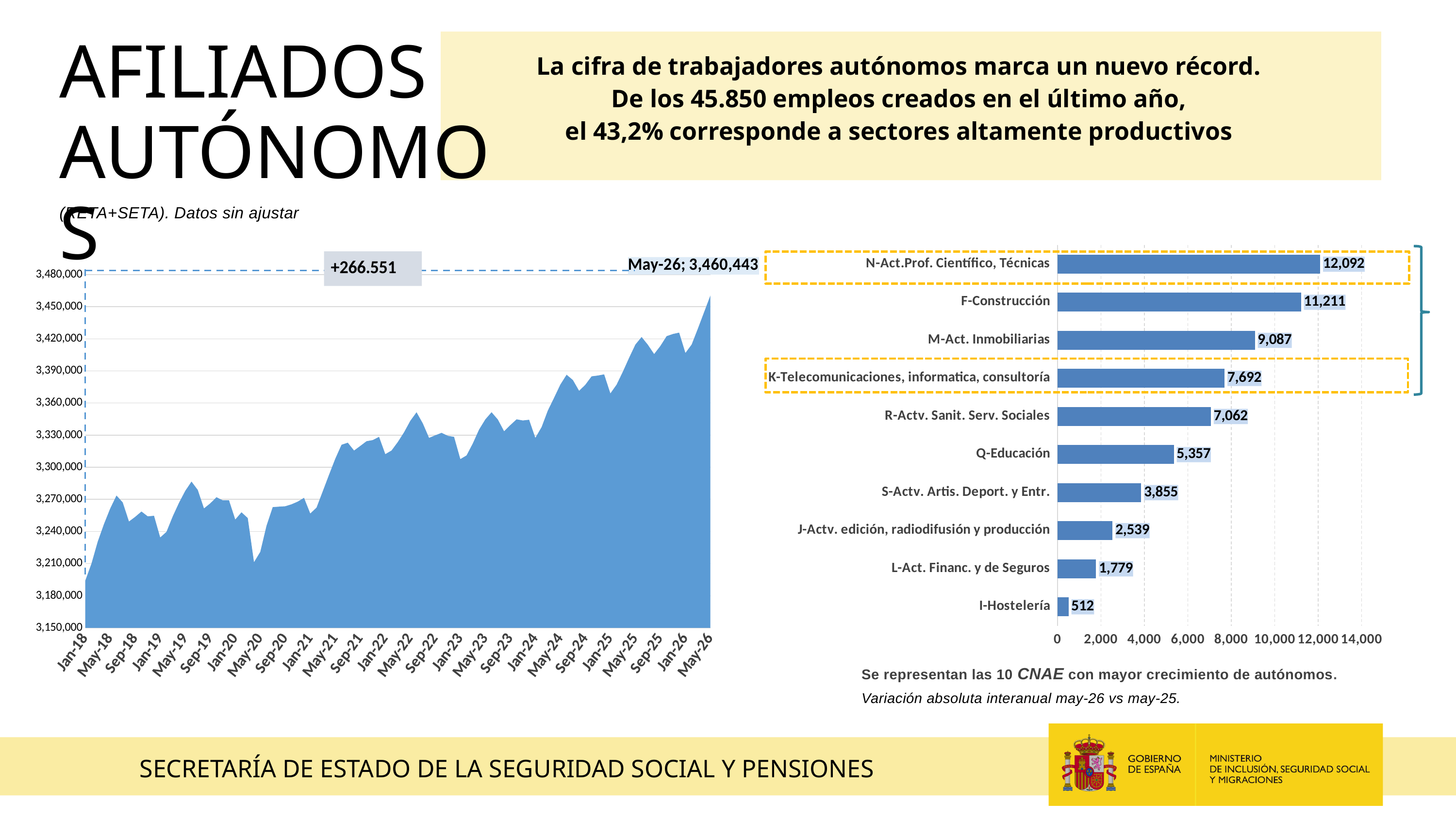
On the bar chart on the right, what is the value for K-Telecomunicaciones, informatica, consultoría? 7,692 On the chart on the left, is the value for Jan-18 greater or less than 3,210,000? less What kind of chart is the chart on the left of the slide? area chart On the bar chart on the right, what is the value for F-Construcción? 11,211 On the chart on the left, do the values generally rise or fall from Jan-18 to May-26? rise On the bar chart on the right, what is the difference between N-Act.Prof. Científico, Técnicas and F-Construcción? 881 On the bar chart on the right, which is larger: Q-Educación or R-Actv. Sanit. Serv. Sociales? R-Actv. Sanit. Serv. Sociales On the bar chart on the right, how many categories are shown? 10 On the chart on the left, what value is labelled for May-26? 3,460,443 On the bar chart on the right, which category has the lowest value? I-Hostelería On the bar chart on the right, is the value for M-Act. Inmobiliarias greater or less than 8,000? greater On the bar chart on the right, which category has the highest value? N-Act.Prof. Científico, Técnicas